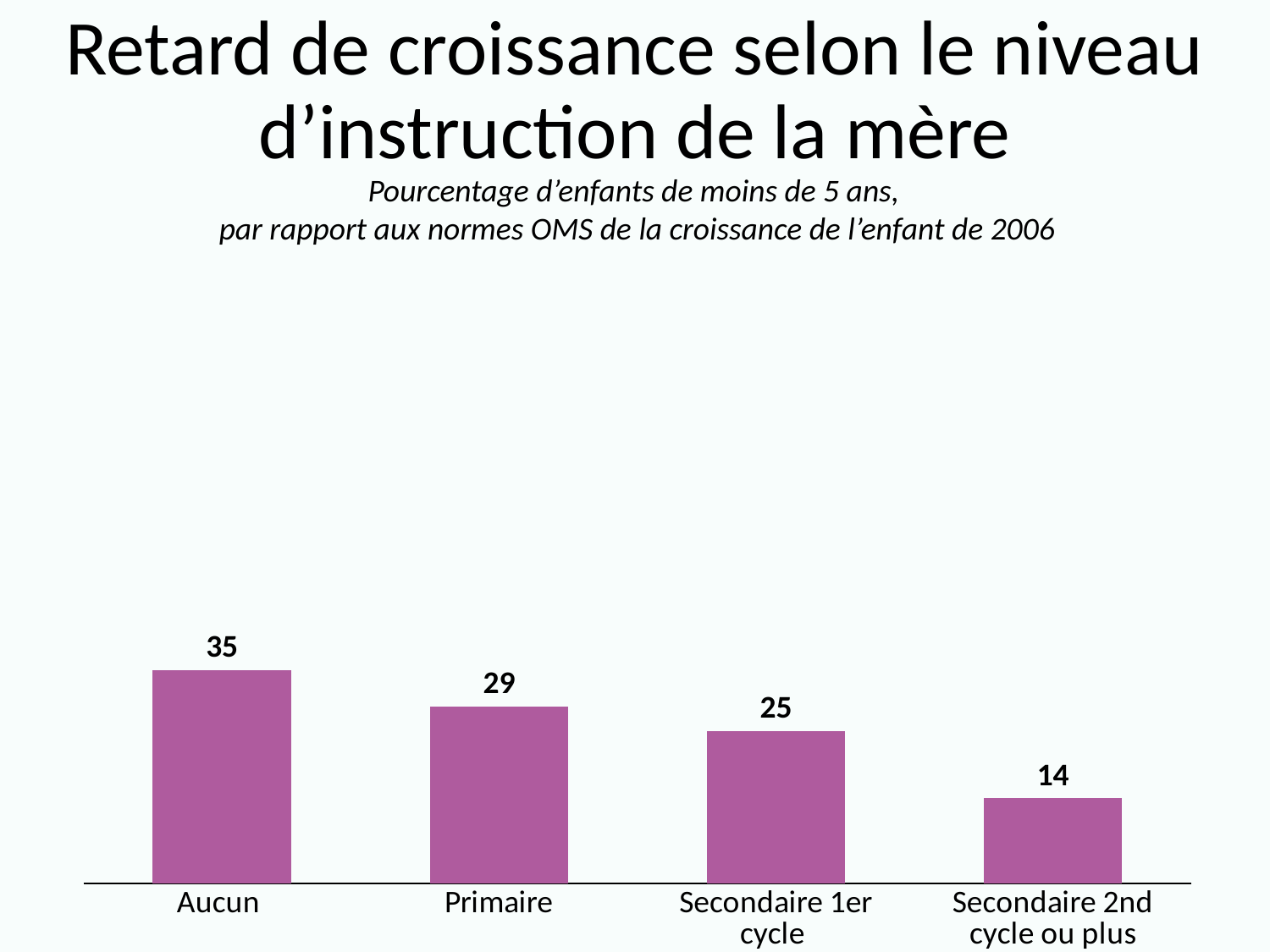
What is the value for Aucun? 35 Which category has the highest value? Aucun Which is larger, the value for Primaire or the value for Secondaire 1er cycle? Primaire What is the value for Secondaire 2nd cycle ou plus? 14 Do the values rise or fall from left to right along the x axis? Fall What is the difference between the values for Aucun and Secondaire 2nd cycle ou plus? 21 Which category has the lowest value? Secondaire 2nd cycle ou plus What is the value for Secondaire 1er cycle? 25 What kind of chart is shown on the slide? Bar chart How many categories are shown on the x axis? 4 What is the value for Primaire? 29 What is the difference between the values for Primaire and Secondaire 1er cycle? 4